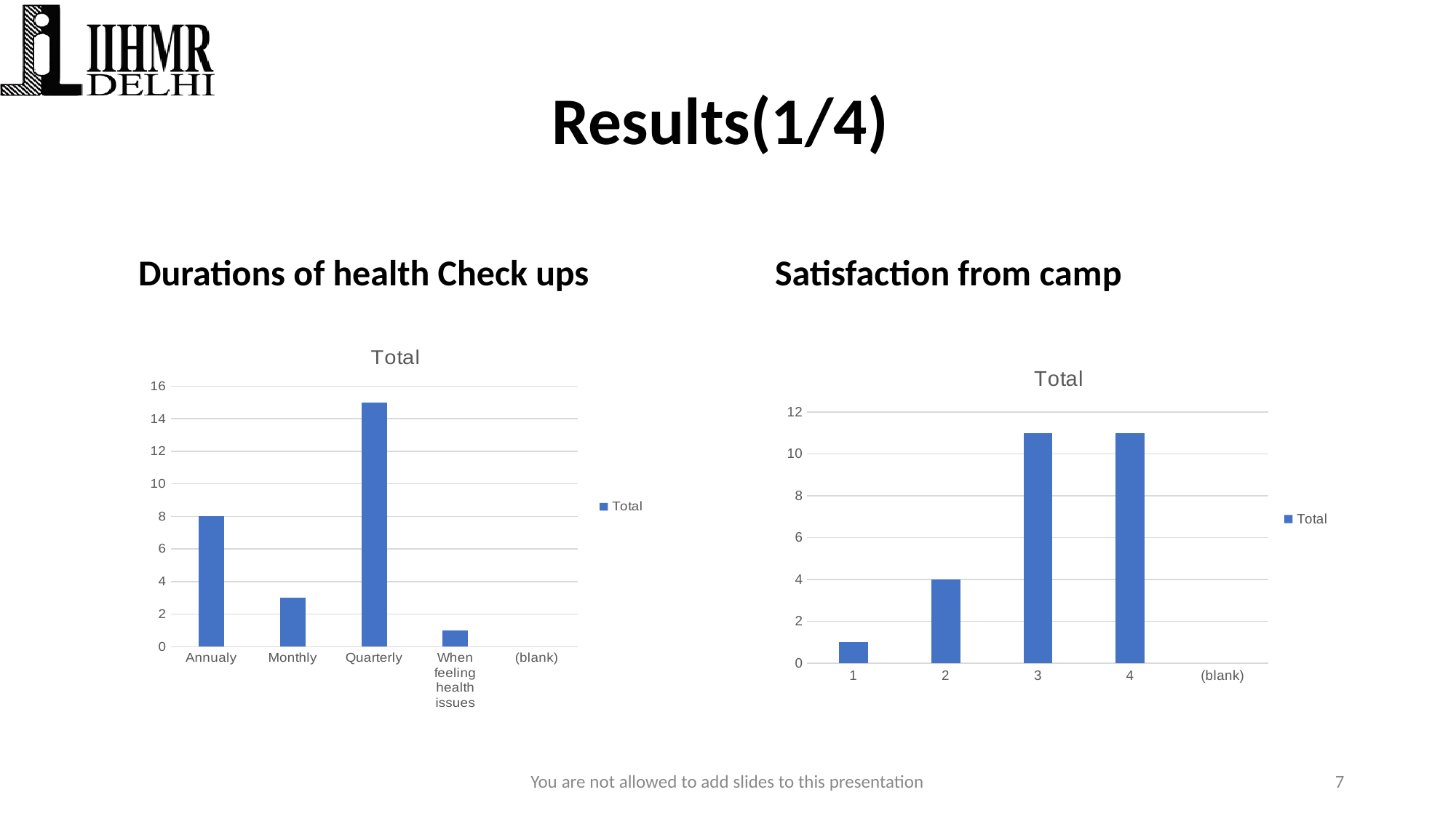
In the Durations of health Check ups chart, is the value for Monthly greater or less than 4? less In the Satisfaction from camp chart, is the value for category 3 greater or less than 10? greater In the Durations of health Check ups chart, is the value for Quarterly greater or less than 14? greater In the Durations of health Check ups chart, which category has the highest value? Quarterly In the Satisfaction from camp chart, which is larger, category 1 or category 2? 2 How many categories are shown on the x axis of the Durations of health Check ups chart? 5 How many series does the legend of the Satisfaction from camp chart list? 1 In the Durations of health Check ups chart, what is the value for Annualy? 8 What kind of chart is the Durations of health Check ups chart? bar chart What is the legend entry shown in the Satisfaction from camp chart? Total In the Durations of health Check ups chart, which is larger, Annualy or Monthly? Annualy In the Satisfaction from camp chart, what is the value for category 2? 4